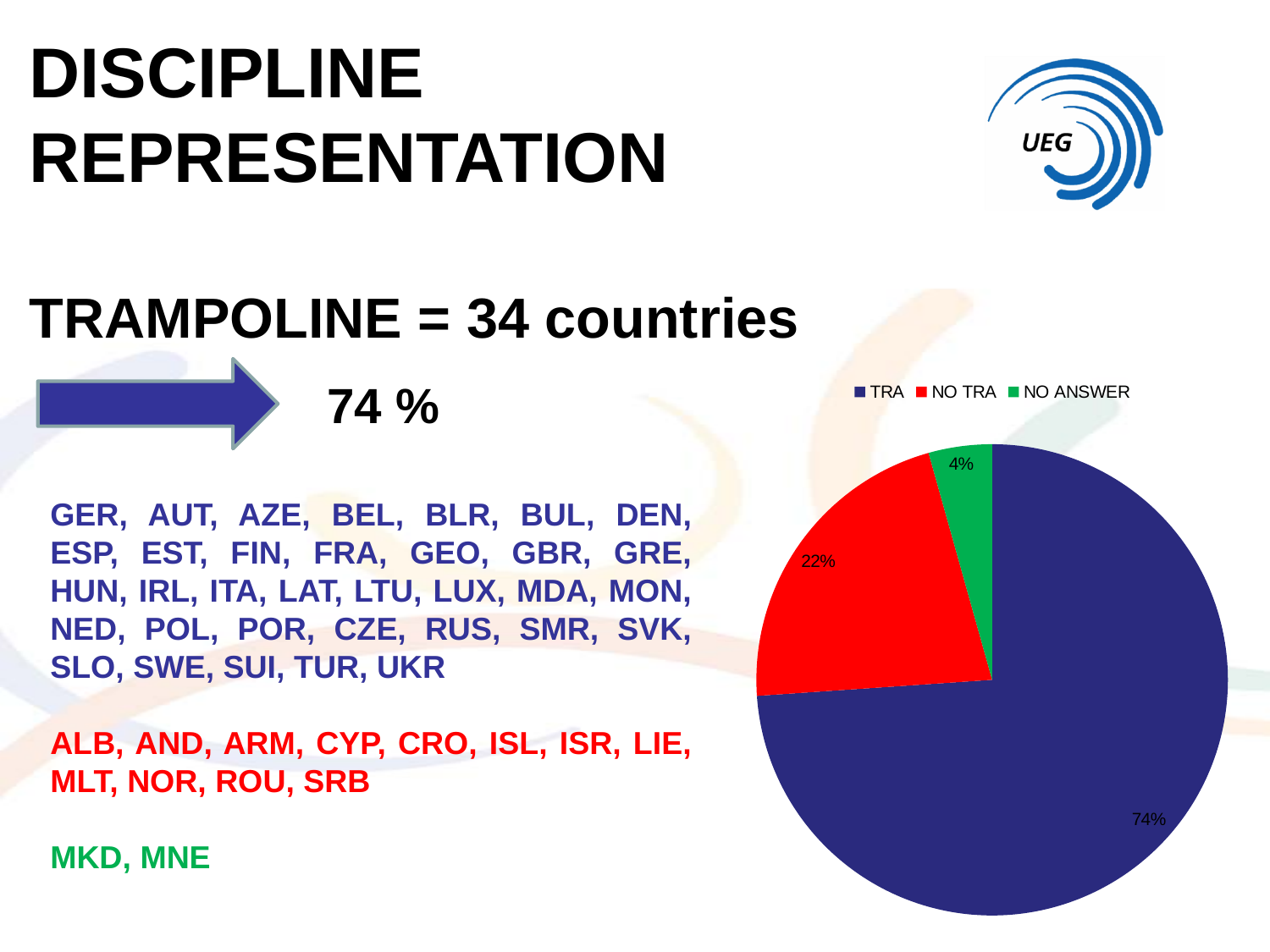
Which slice of the pie is the largest? TRA What kind of chart is shown on the slide? pie chart Which slice of the pie is the smallest? NO ANSWER Which is larger, the NO TRA slice or the NO ANSWER slice? NO TRA What is the difference in percentage points between the TRA and NO TRA slices? 52 How many slices does the pie chart have? 3 What share of the pie does NO ANSWER represent? 4% What is the difference in percentage points between the NO TRA and NO ANSWER slices? 18 How many entries does the legend list? 3 What share of the pie does NO TRA represent? 22% What colour is the NO TRA slice in the pie chart? red What share of the pie does TRA represent? 74%